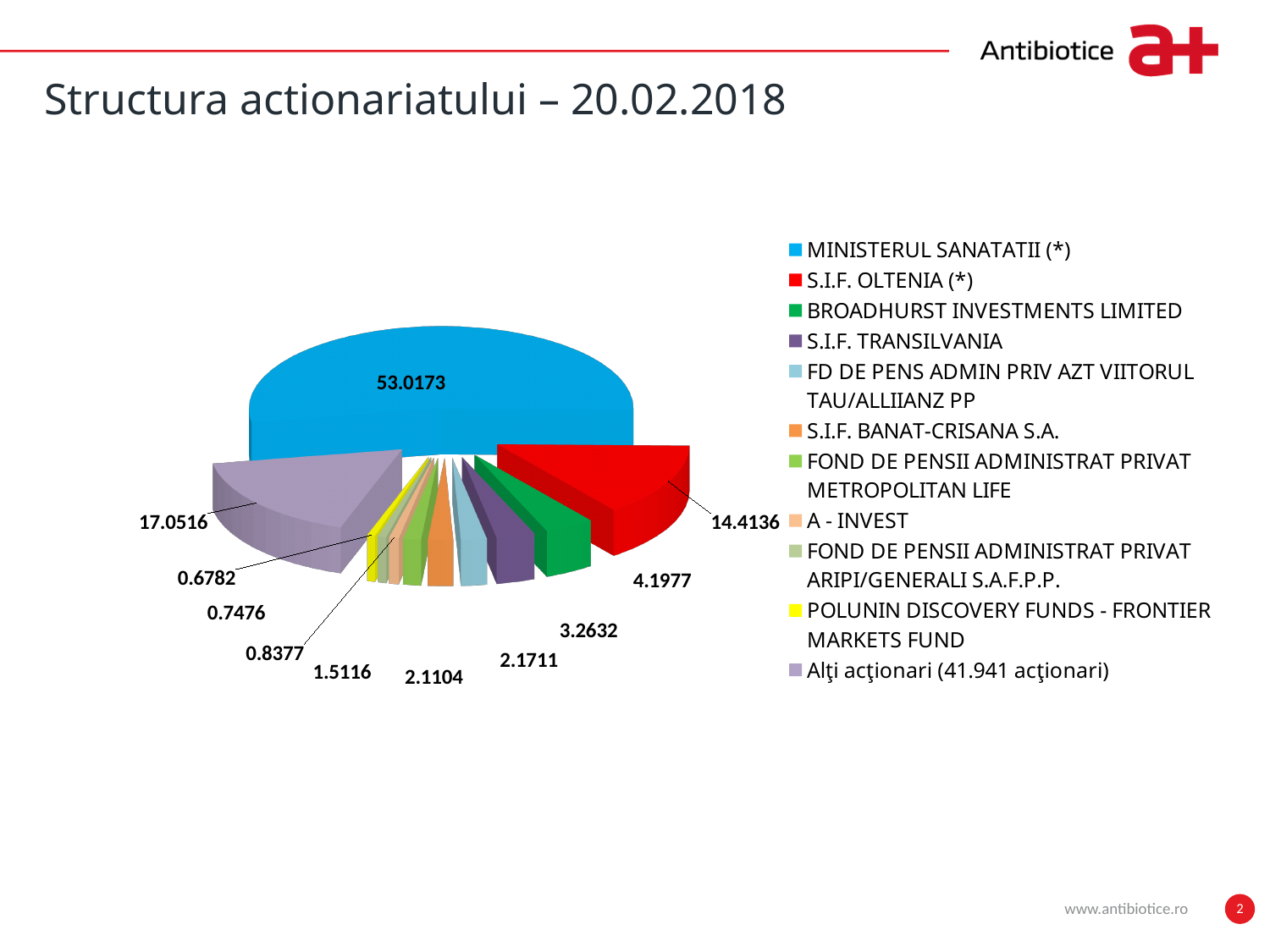
What is the difference between the values for MINISTERUL SANATATII (*) and S.I.F. OLTENIA (*)? 38.6037 Which shareholder has the largest slice of the pie? MINISTERUL SANATATII (*) What is the title of the slide containing the chart? Structura actionariatului – 20.02.2018 What is the value shown for BROADHURST INVESTMENTS LIMITED? 4.1977 What is the value shown for S.I.F. TRANSILVANIA? 3.2632 Which is larger, the value for Alţi acţionari (41.941 acţionari) or the value for S.I.F. OLTENIA (*)? Alţi acţionari (41.941 acţionari) What is the value shown for MINISTERUL SANATATII (*)? 53.0173 What is the value shown for S.I.F. OLTENIA (*)? 14.4136 How many entries does the legend list? 11 What kind of chart is shown on the slide? pie chart What is the value shown for Alţi acţionari (41.941 acţionari)? 17.0516 Which shareholder has the smallest slice of the pie? POLUNIN DISCOVERY FUNDS - FRONTIER MARKETS FUND